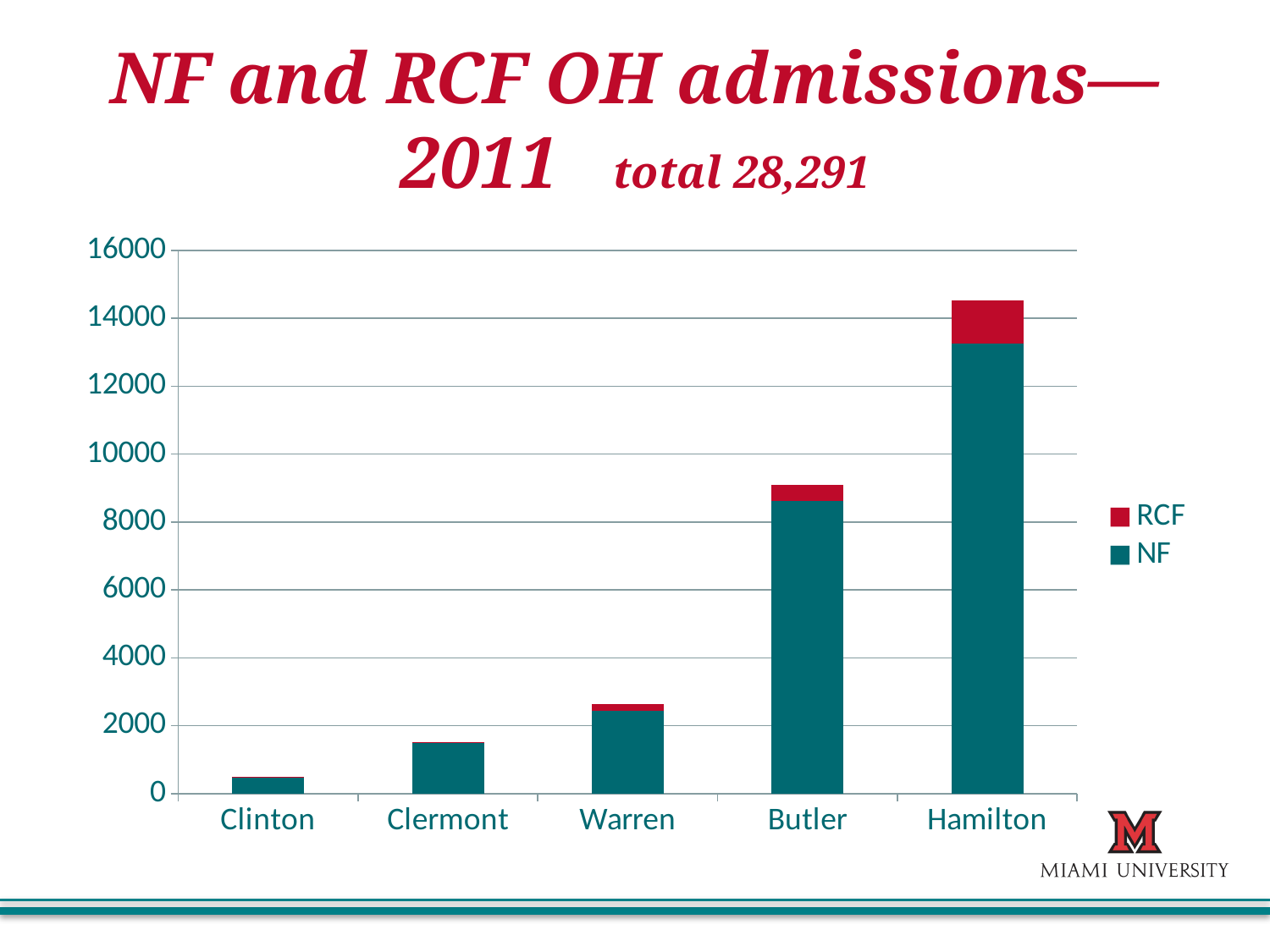
Which county has the lowest total admissions in the chart? Clinton How many counties are shown on the x axis of the chart? 5 Is the total value for Butler greater or less than 8000? greater How many series does the legend list? 2 Which county has the highest total admissions in the chart? Hamilton What kind of chart is shown on the slide? Stacked bar chart Do the total admissions rise or fall moving from Clinton to Hamilton along the x axis? rise Is the total value for Clermont greater or less than 2000? less Which series is shown in red in the legend? RCF Which county has more total admissions, Butler or Warren? Butler Is the total value for Hamilton greater or less than 14000? greater What total number of admissions is stated in the slide title? 28,291